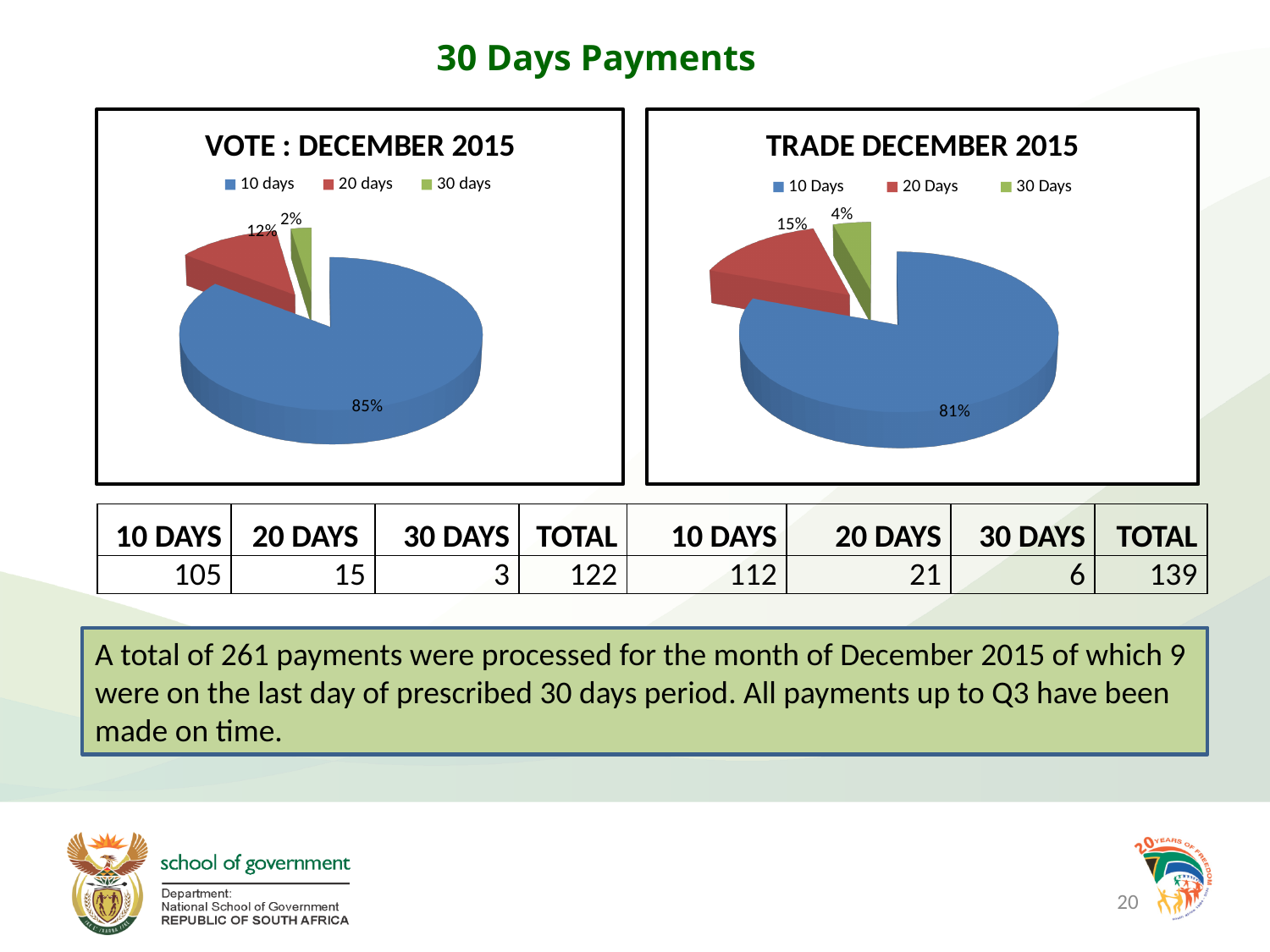
What kind of chart is the TRADE DECEMBER 2015 chart? Pie chart In the TRADE DECEMBER 2015 chart, what share of the pie is 10 Days? 81% In the TRADE DECEMBER 2015 chart, what share of the pie is 30 Days? 4% In the TRADE DECEMBER 2015 chart, what is the difference in percentage points between the 20 Days and 30 Days slices? 11% In the VOTE : DECEMBER 2015 chart, which category has the largest slice? 10 days In the TRADE DECEMBER 2015 chart, which category has the smallest slice? 30 Days In the VOTE : DECEMBER 2015 chart, what share of the pie is 20 days? 12% How many slices does the VOTE : DECEMBER 2015 pie chart have? 3 In the VOTE : DECEMBER 2015 chart, which colour represents 20 days? Red